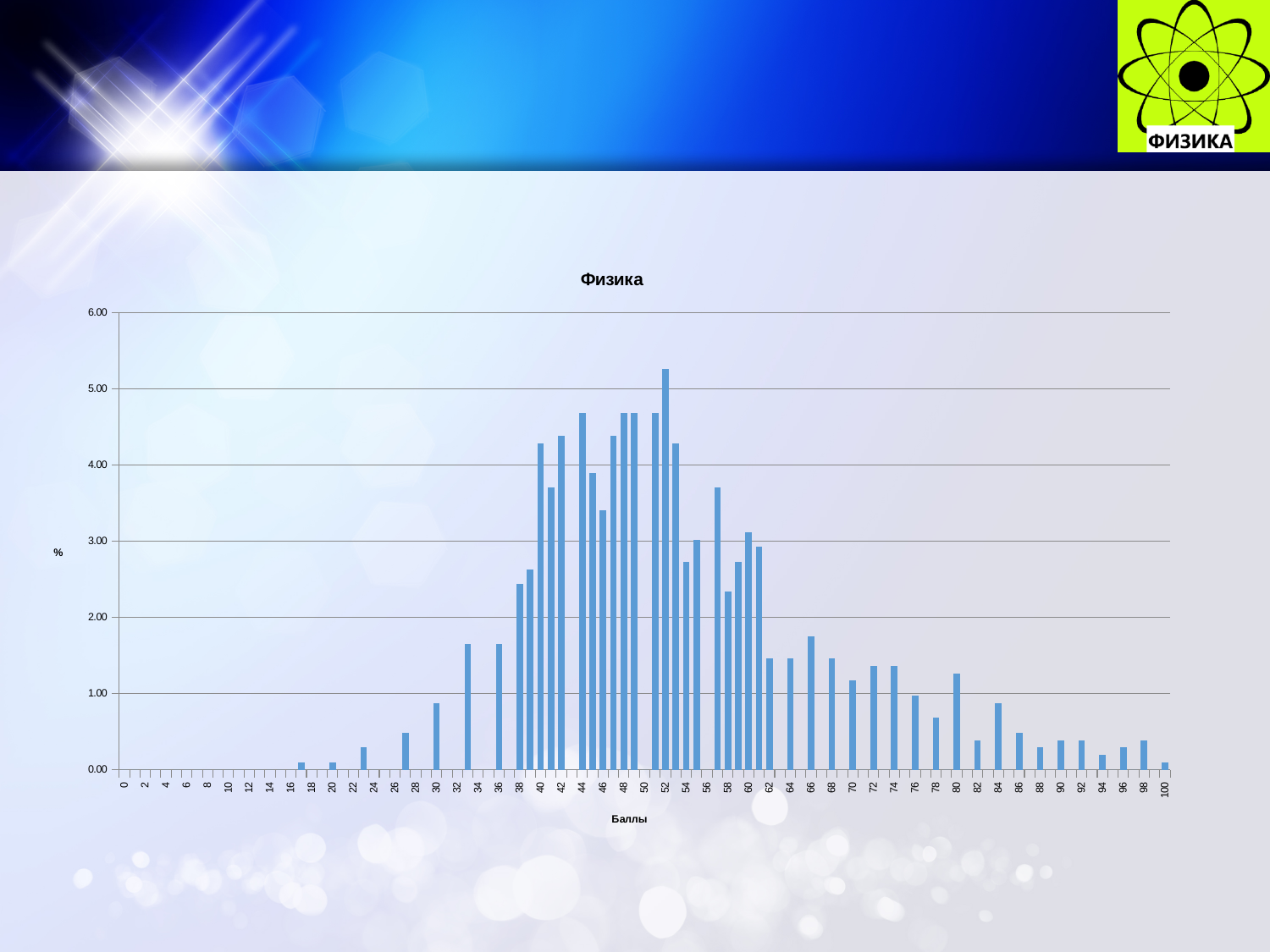
Which has the larger value, score 30 or score 66? 66 What is the title of the chart? Физика What kind of chart is shown on the slide? bar chart Do the values generally rise or fall as the score increases from 52 to 100? fall Is the value for score 52 greater or less than 5.00? greater Which has the larger value, score 52 or score 40? 52 Is the value for score 100 greater or less than 1.00? less Is the value for score 40 greater or less than 4.00? greater Which score (Баллы) has the highest percentage value? 52 What is the label of the x axis of the chart? Баллы